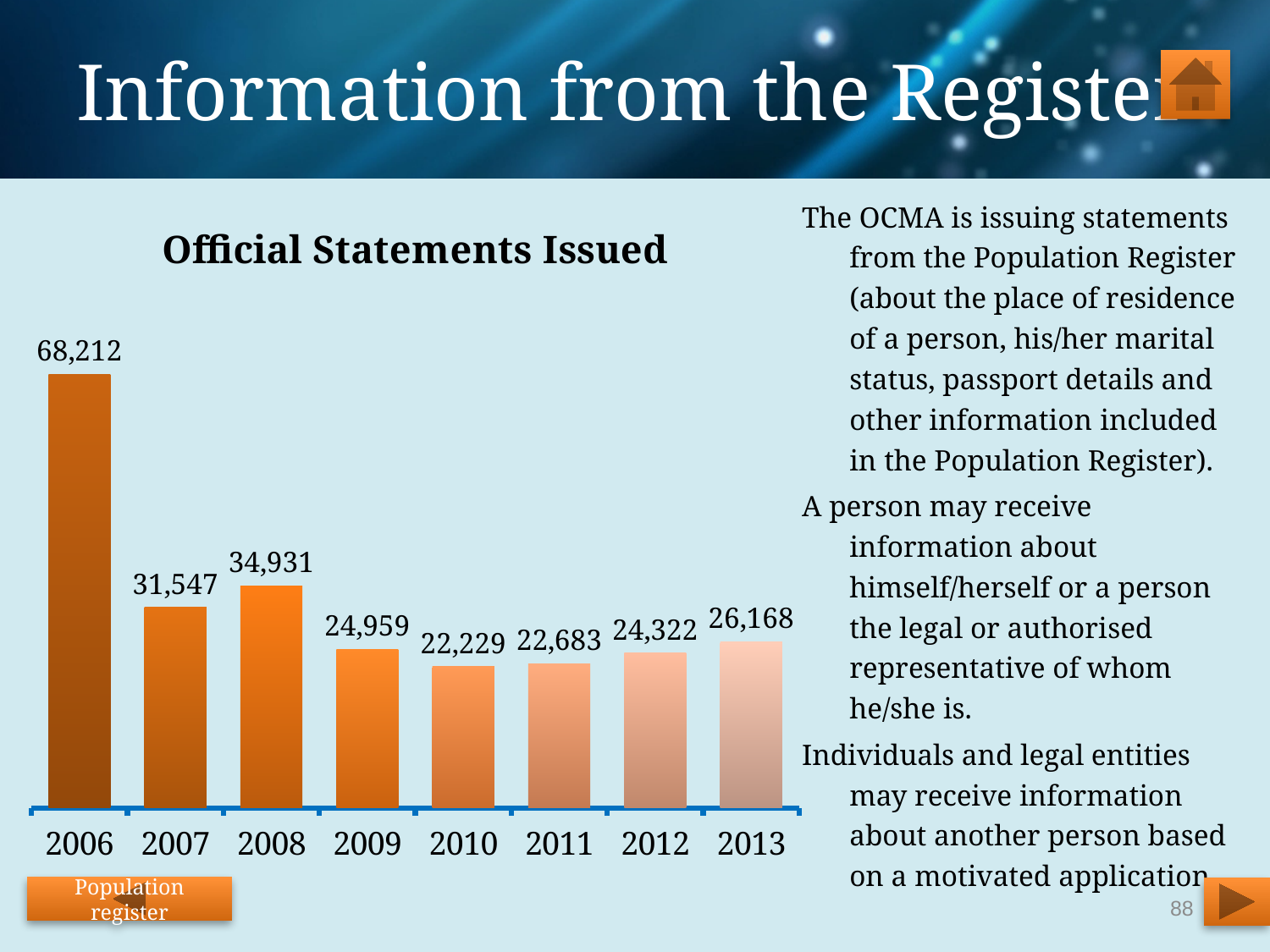
What is the value shown for 2013? 26,168 Which year has the lowest number of official statements issued? 2010 Which year has the highest number of official statements issued? 2006 Which year has a larger value, 2007 or 2008? 2008 How many official statements were issued in 2010? 22,229 What is the difference between the values for 2008 and 2009? 9,972 What is the value for 2006 in the Official Statements Issued chart? 68,212 Which year has a larger value, 2012 or 2013? 2013 What is the title of the chart on the slide? Official Statements Issued What kind of chart is used to show the official statements issued? Bar chart How many years are shown on the x axis of the chart? 8 What is the difference between the values for 2006 and 2007? 36,665